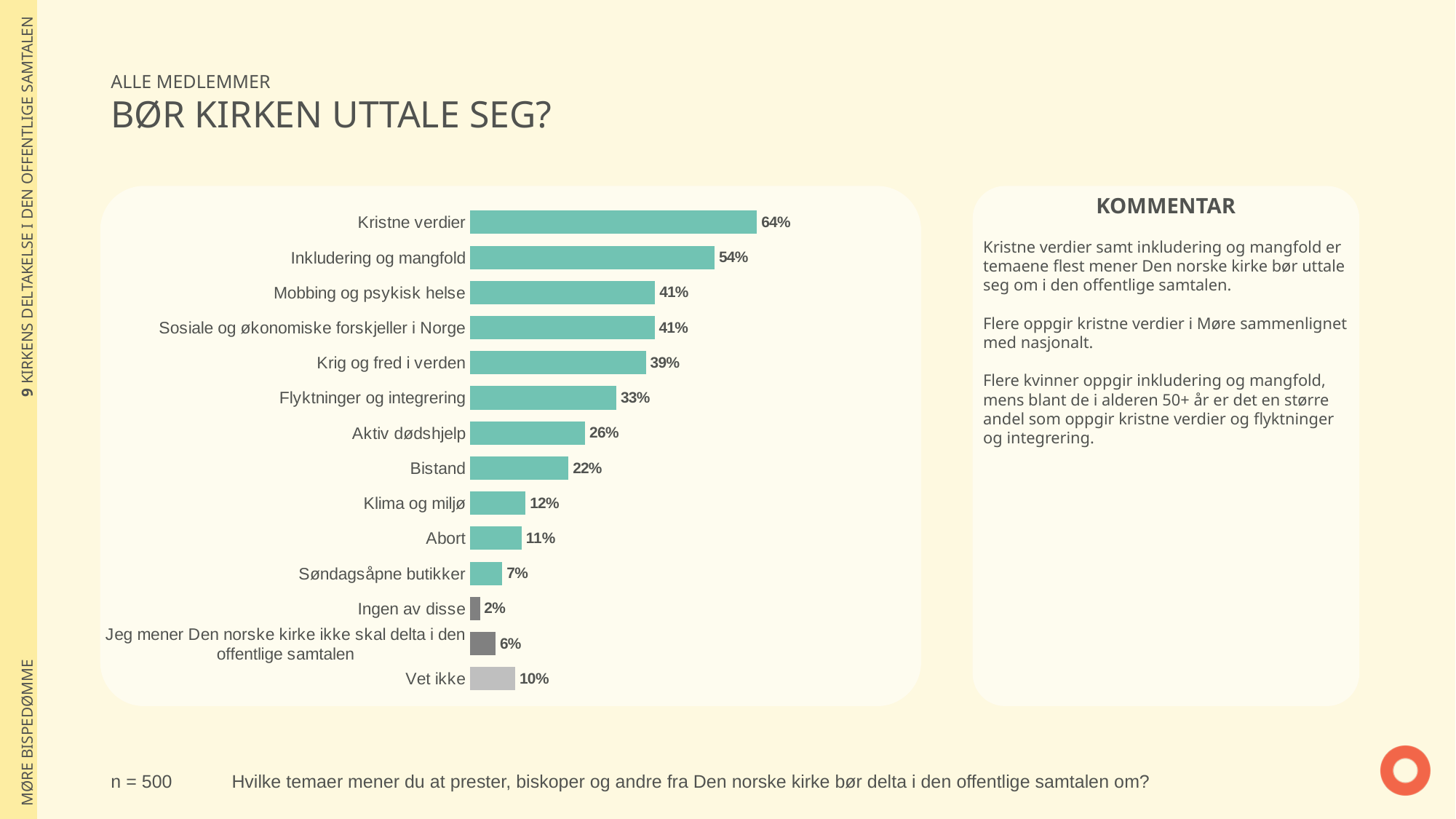
How many categories are shown in the chart? 14 Which category has the lowest value? Ingen av disse What kind of chart is shown on the slide? Bar chart What is the sample size (n) stated on the slide? 500 Which category has the highest value? Kristne verdier Which is larger, the value for Aktiv dødshjelp or the value for Bistand? Aktiv dødshjelp What is the value for Vet ikke? 10% What is the difference between the values for Bistand and Klima og miljø? 10% What is the difference between the values for Kristne verdier and Inkludering og mangfold? 10% What is the value for Kristne verdier? 64% What is the value for Flyktninger og integrering? 33% Which is larger, the value for Abort or the value for Søndagsåpne butikker? Abort